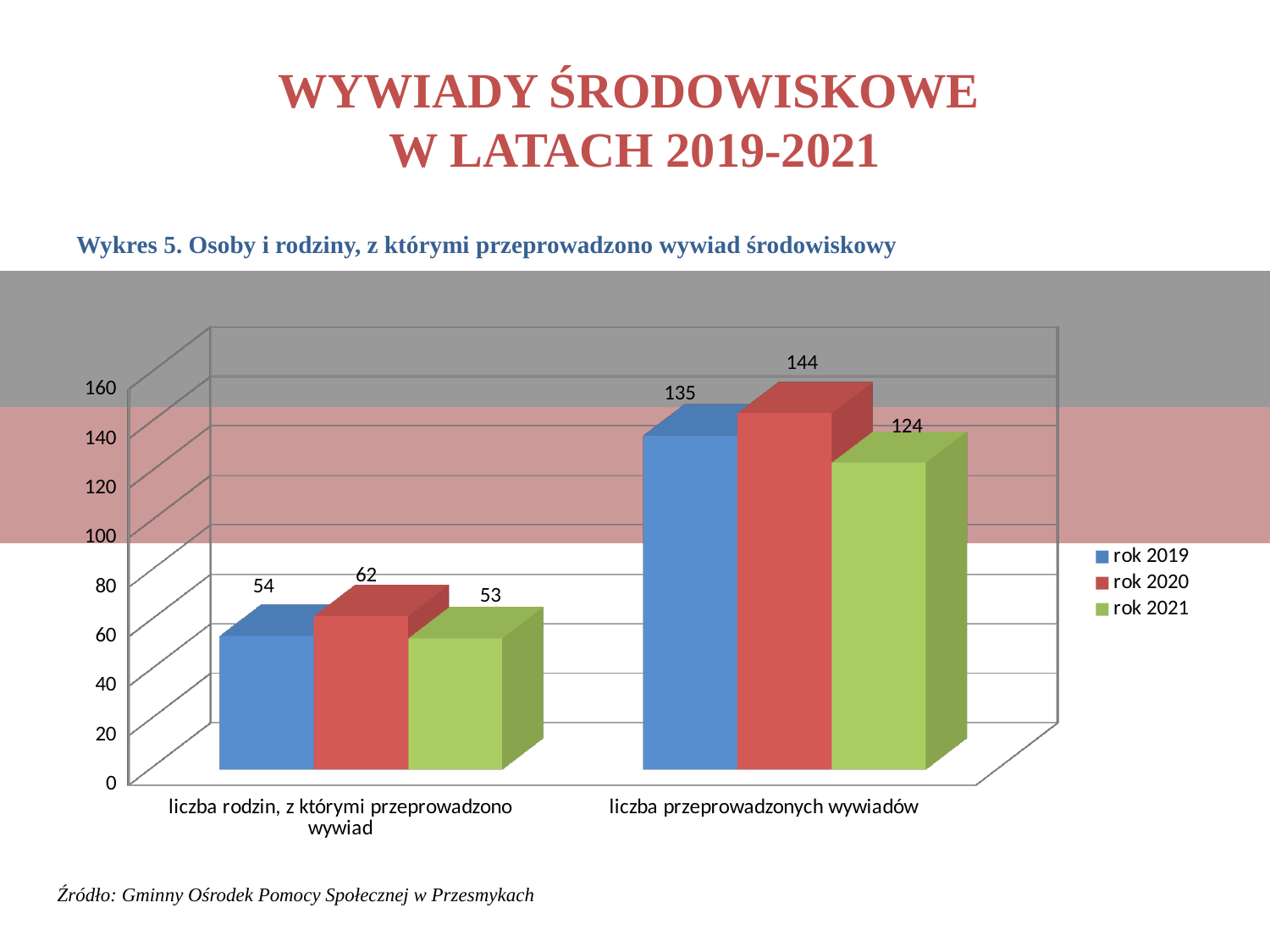
What is the value for rok 2019 in the category 'liczba przeprowadzonych wywiadów'? 135 What is the difference between the rok 2020 and rok 2019 values in the category 'liczba rodzin, z którymi przeprowadzono wywiad'? 8 What is the value for rok 2020 in the category 'liczba przeprowadzonych wywiadów'? 144 Which year has the lowest value in the category 'liczba przeprowadzonych wywiadów'? rok 2021 How many series does the legend list? 3 Which year has the highest value in the category 'liczba rodzin, z którymi przeprowadzono wywiad'? rok 2020 What kind of chart is shown on the slide? bar chart What is the difference between the rok 2020 and rok 2021 values in the category 'liczba przeprowadzonych wywiadów'? 20 Which is larger: the rok 2019 value or the rok 2021 value in the category 'liczba rodzin, z którymi przeprowadzono wywiad'? rok 2019 What is the value for rok 2021 in the category 'liczba rodzin, z którymi przeprowadzono wywiad'? 53 How many categories are shown on the x axis? 2 Is the rok 2021 value for 'liczba przeprowadzonych wywiadów' greater or less than 100? greater